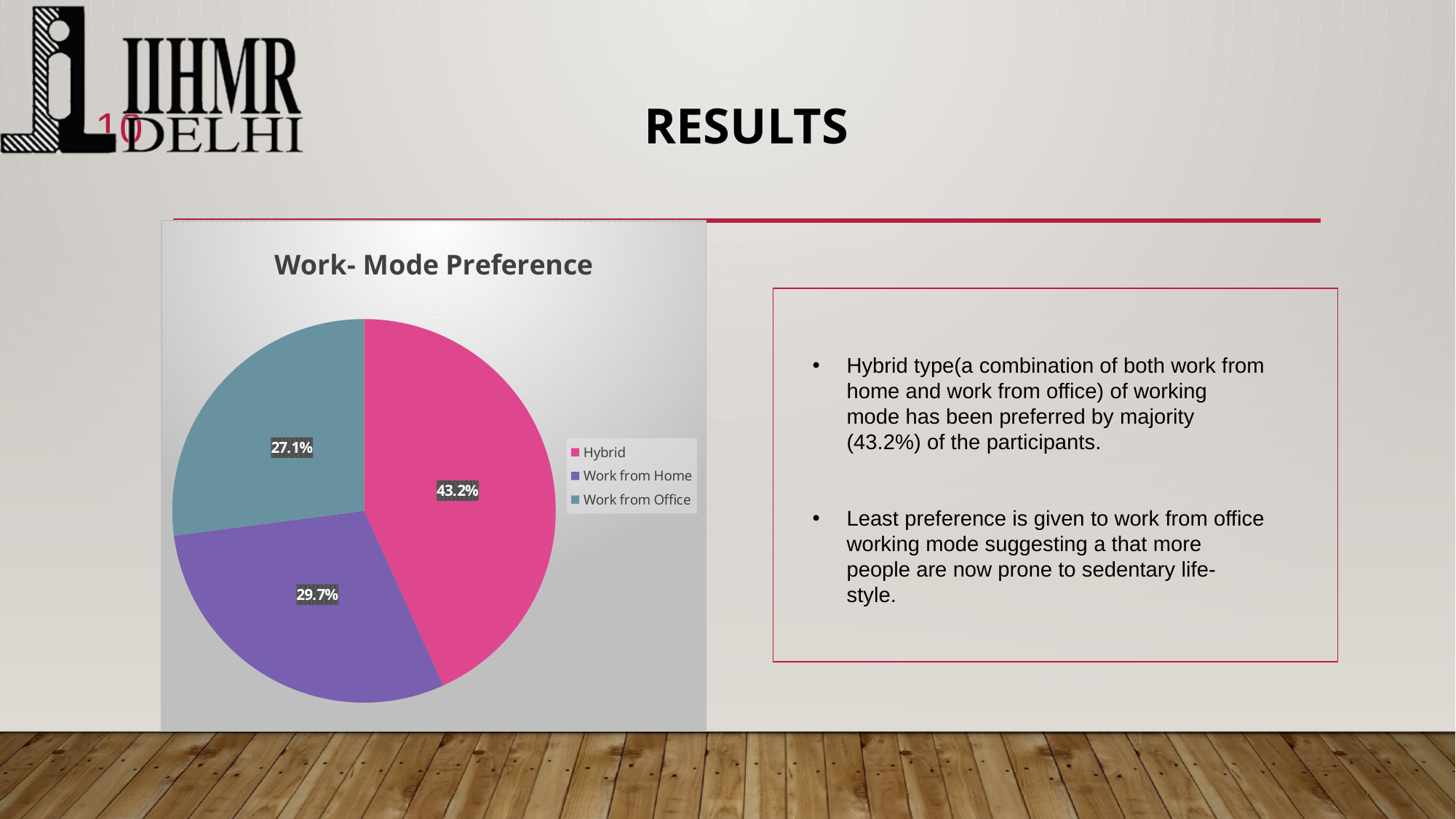
What is the title of the chart? Work- Mode Preference What percentage of participants preferred Work from Office? 27.1% What is the difference in percentage points between Work from Home and Work from Office? 2.6 Which is larger, the share for Hybrid or the share for Work from Home? Hybrid What is the difference in percentage points between Hybrid and Work from Office? 16.1 Which work mode has the smallest share of the pie? Work from Office What percentage of participants preferred Work from Home? 29.7% How many categories does the pie chart show? 3 What percentage of participants preferred Hybrid? 43.2% What type of chart is shown on the slide? pie chart Which colour represents Work from Home in the pie chart? purple Which work mode has the largest share of the pie? Hybrid